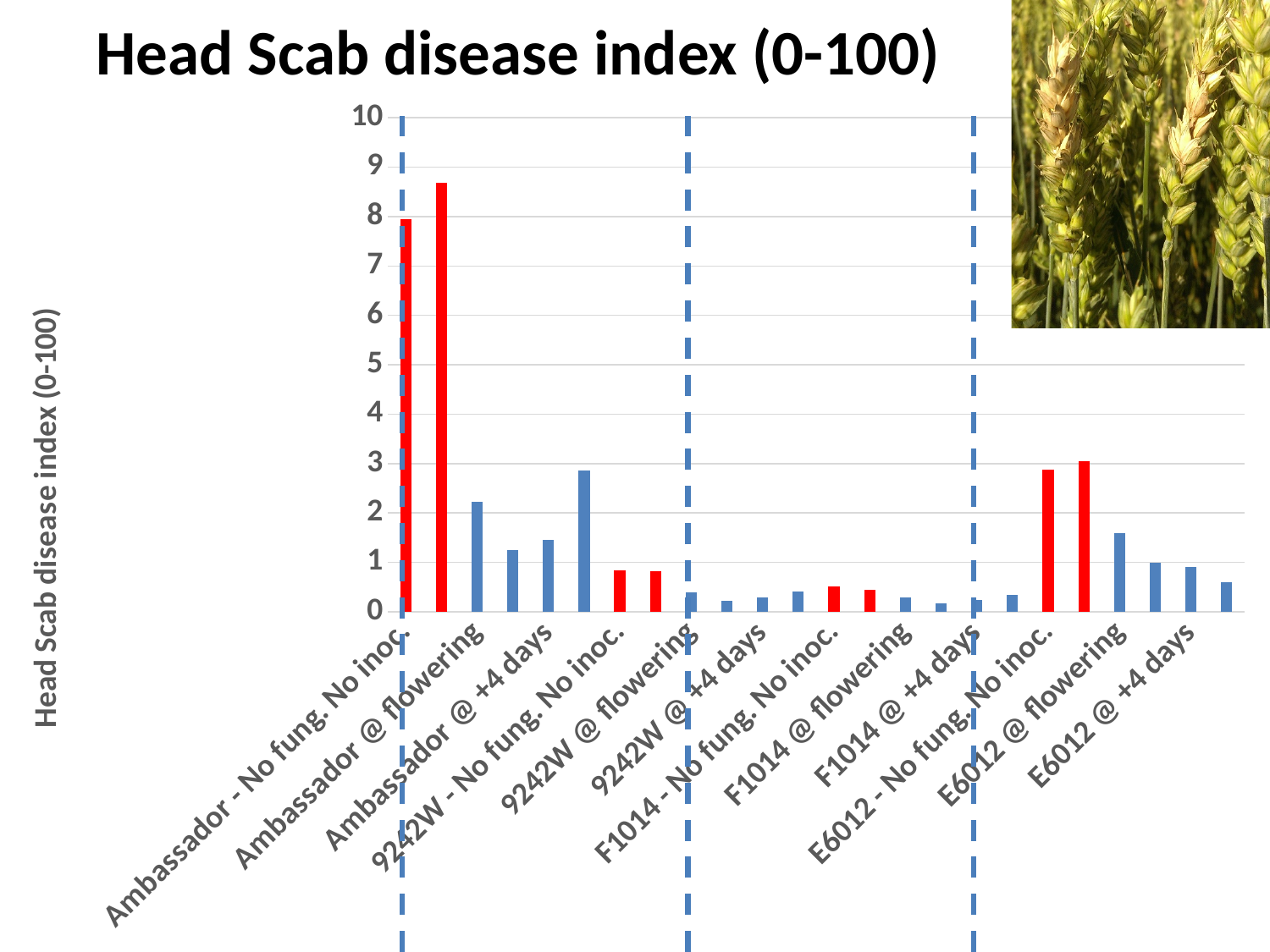
Is the tallest bar in the chart greater or less than 9? less Is the tallest blue bar in the chart greater or less than 4? less Are the tallest bars located at the left end or the right end of the chart? Left end What is the title of the chart? Head Scab disease index (0-100) What kind of chart is shown on the slide? Bar chart How many category labels are shown along the horizontal axis? 12 Is the tallest bar in the chart greater or less than 8? greater What is the label on the vertical axis of the chart? Head Scab disease index (0-100) What is the highest value shown on the vertical axis? 10 Which colour are the tallest bars in the chart, red or blue? Red